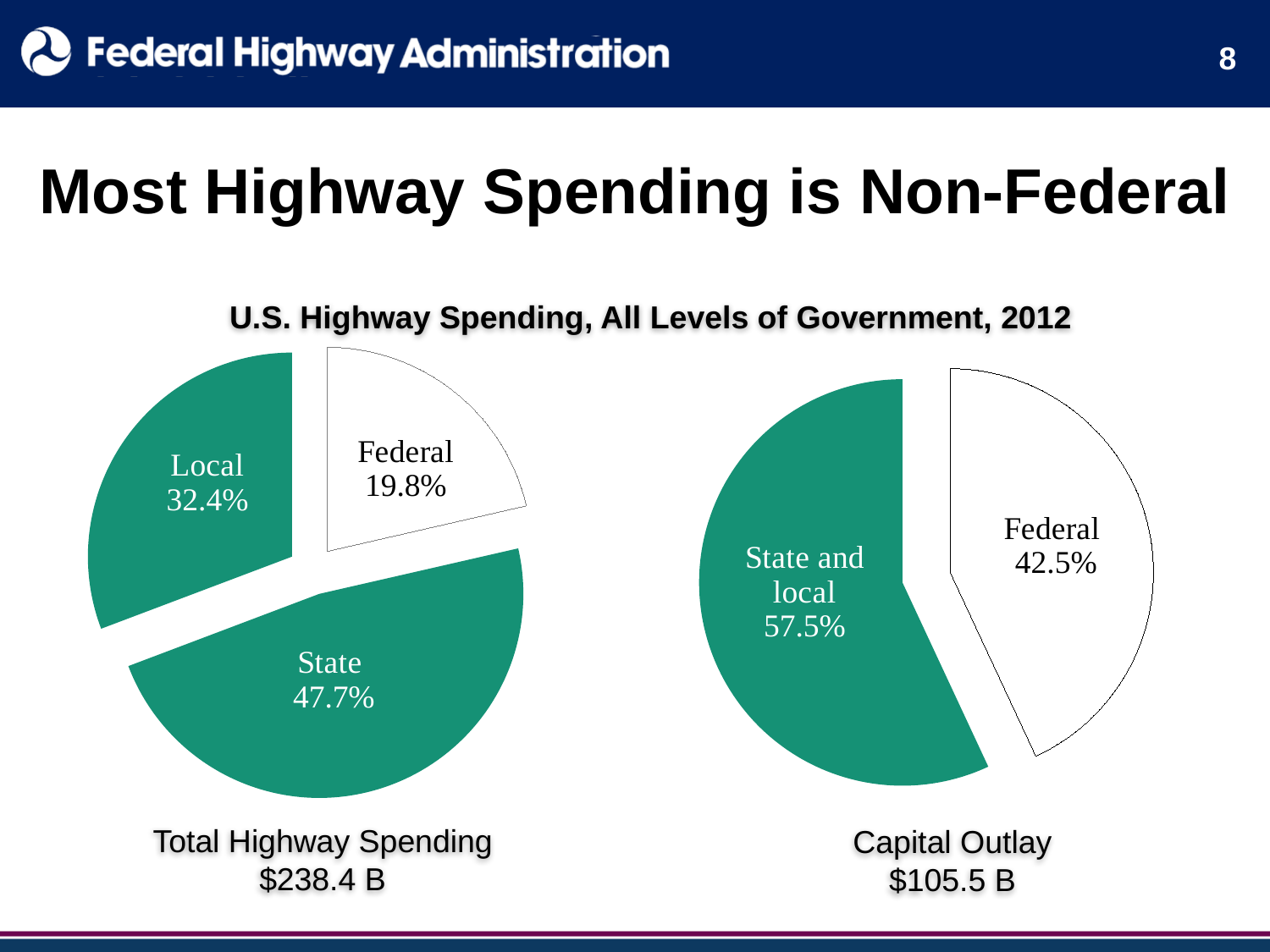
In the Total Highway Spending pie chart, what share of spending is State? 47.7% How many slices does the Total Highway Spending pie chart have? 3 In the Capital Outlay pie chart, what share is State and local? 57.5% In the Total Highway Spending pie chart, what share of spending is Federal? 19.8% In the Total Highway Spending pie chart, which category has the largest share? State In the Total Highway Spending pie chart, which category has the smallest share? Federal In the Capital Outlay pie chart, what share is Federal? 42.5% In the Capital Outlay pie chart, which is larger, Federal or State and local? State and local What total dollar amount is shown beneath the Capital Outlay pie chart? $105.5 B In the Total Highway Spending pie chart, what is the difference between the State share and the Federal share? 27.9% What type of chart is the Capital Outlay chart? Pie chart In the Total Highway Spending pie chart, what share of spending is Local? 32.4%